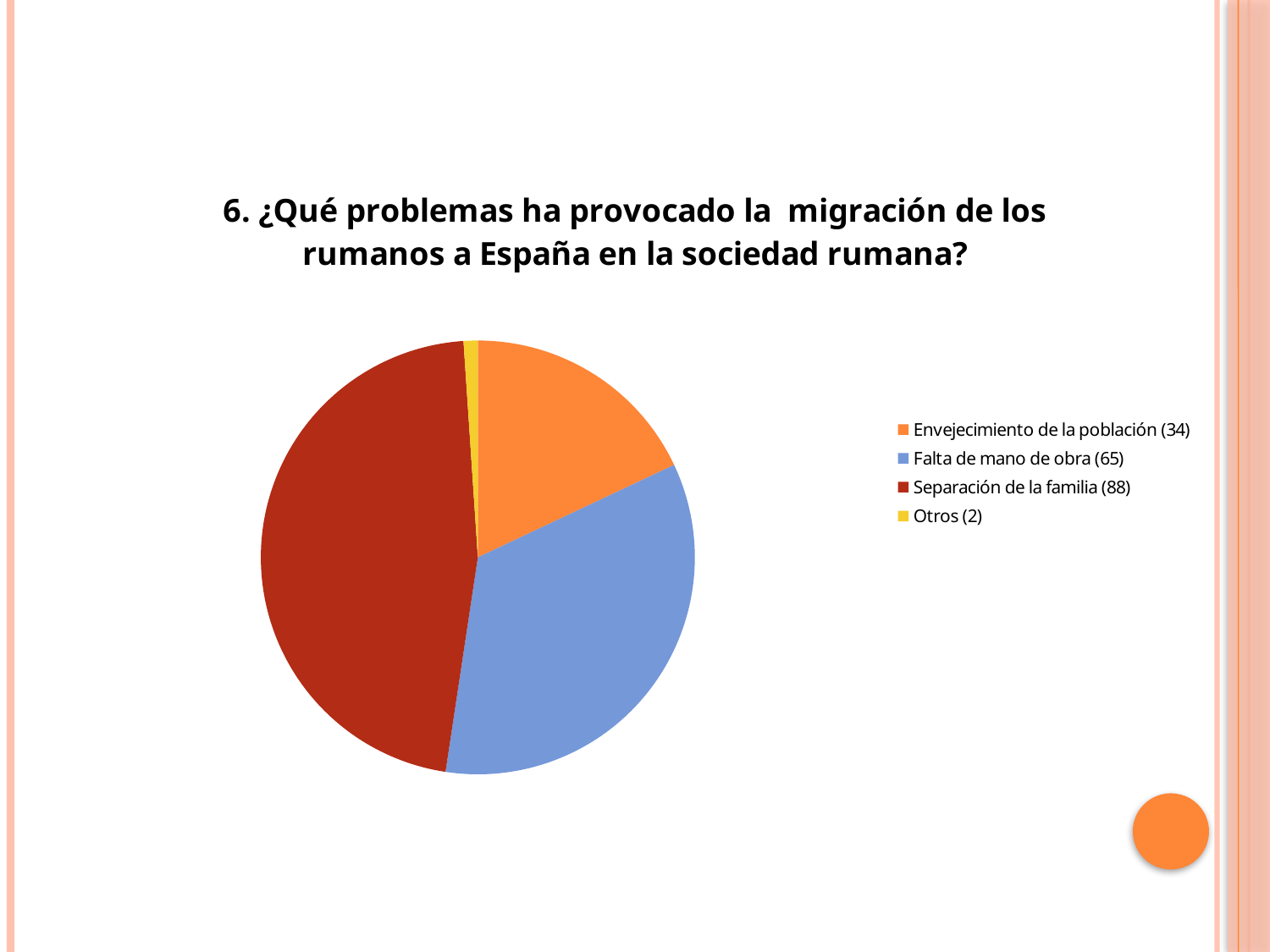
How many categories does the pie chart show? 4 What is the value for Falta de mano de obra? 65 What is the total of all four values shown in the legend? 189 Which category has the highest value? Separación de la familia What kind of chart is shown on the slide? pie chart Which category has the lowest value? Otros What colour is the slice for Separación de la familia? red What is the difference between the values for Separación de la familia and Falta de mano de obra? 23 What is the value for Separación de la familia? 88 What is the value for Otros? 2 Which is larger, the value for Falta de mano de obra or the value for Envejecimiento de la población? Falta de mano de obra What is the value for Envejecimiento de la población? 34